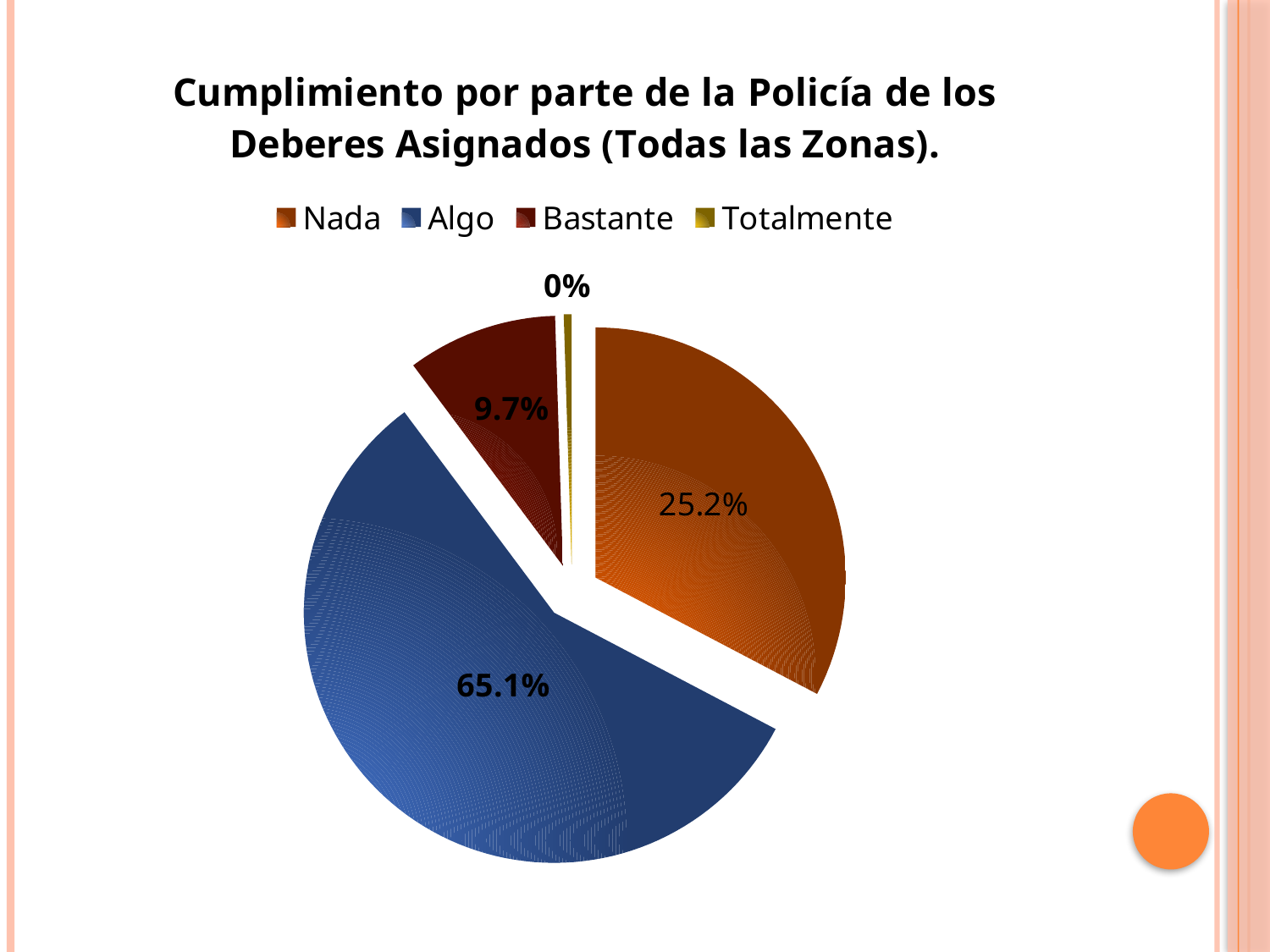
Which category has the largest share of the pie? Algo Which is larger, the value for Nada or the value for Bastante? Nada What is the value for Nada? 25.2% How many categories does the legend list? 4 What is the value for Totalmente? 0% What colour is the slice for Algo? blue What type of chart is shown on the slide? pie chart Which category has the smallest share of the pie? Totalmente What is the value for Bastante? 9.7% What is the title of the chart? Cumplimiento por parte de la Policía de los Deberes Asignados (Todas las Zonas). What is the difference between the values for Algo and Nada? 39.9% What is the value for Algo? 65.1%